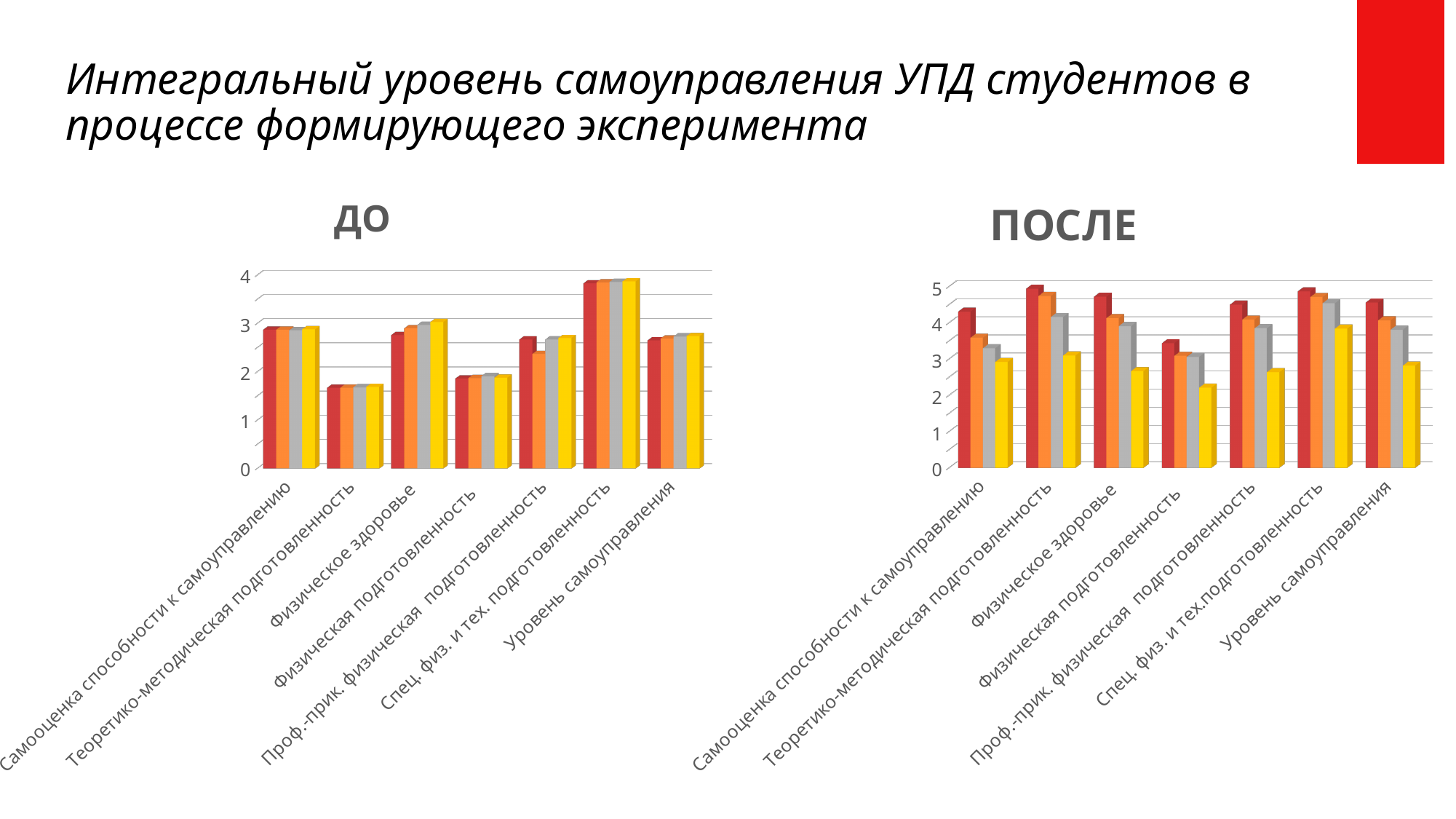
In the "ПОСЛЕ" chart, is the first (red) bar for "Теоретико-методическая подготовленность" greater or less than 4? greater In the "ДО" chart, which category has the lowest bars? Теоретико-методическая подготовленность How many categories are shown on the x axis of the "ПОСЛЕ" chart? 7 In the "ДО" chart, are the bars for "Теоретико-методическая подготовленность" greater or less than 2? less In the "ПОСЛЕ" chart, which category has the lowest bars overall? Физическая подготовленность In the "ПОСЛЕ" chart, is the last (yellow) bar for "Физическая подготовленность" greater or less than 3? less In the "ДО" chart, which category has the highest bars? Спец. физ. и тех. подготовленность What are the titles of the two charts on the slide? ДО and ПОСЛЕ What kind of chart is the "ДО" chart? bar chart How many categories are shown on the x axis of the "ДО" chart? 7 In the "ДО" chart, which category has larger bars: "Спец. физ. и тех. подготовленность" or "Физическая подготовленность"? Спец. физ. и тех. подготовленность